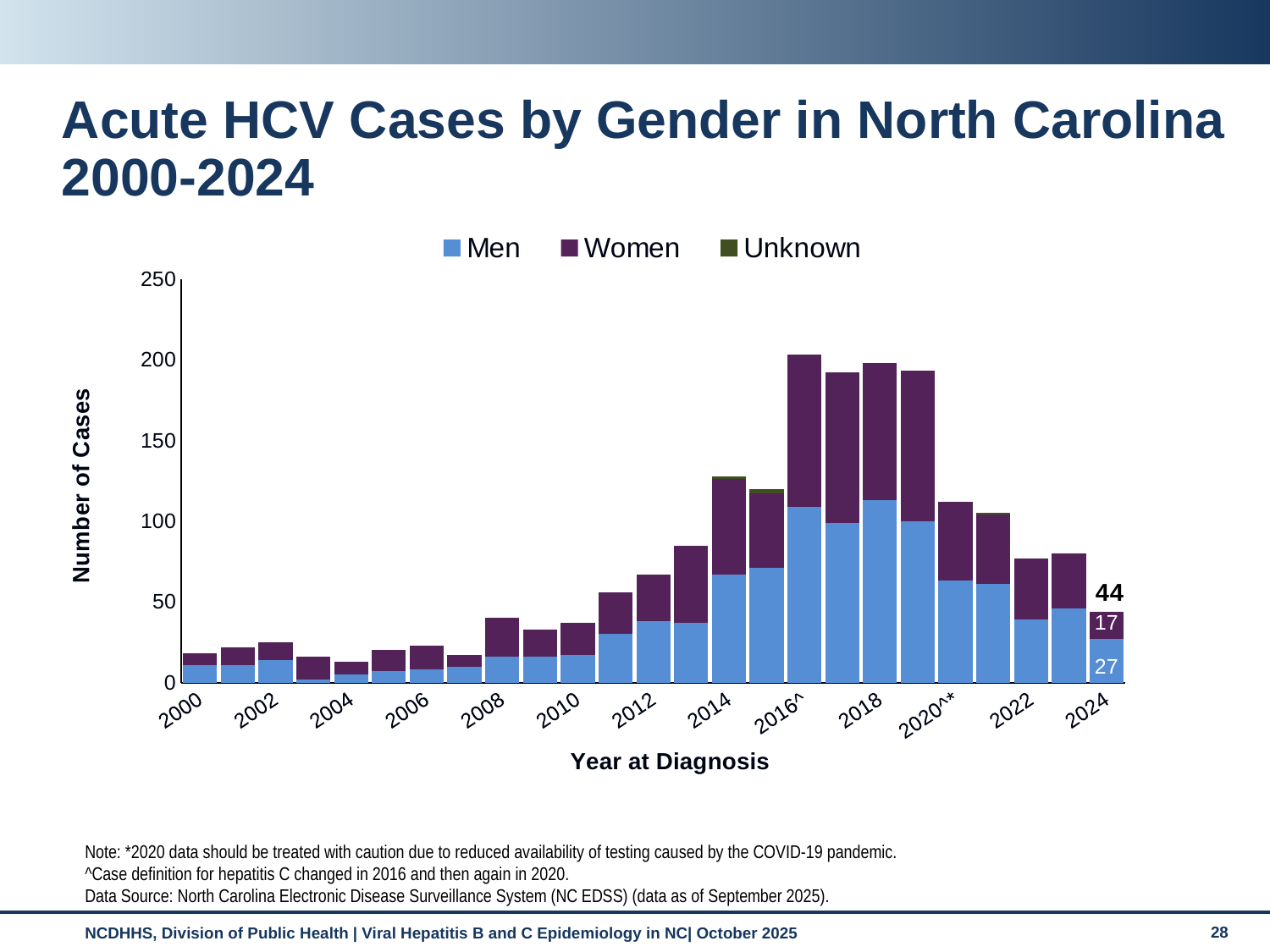
How many years are plotted on the x axis? 25 What kind of chart is shown on the slide? Stacked bar chart Do the total cases rise or fall from 2018 to 2024? fall How many cases among men were reported in 2024? 27 In 2024, how many more cases were among men than among women? 10 Is the total number of cases in 2014 greater or less than 100? greater What is the total number of acute HCV cases shown for 2024? 44 How many series does the legend list? 3 How many cases among women were reported in 2024? 17 What is the title of the x axis? Year at Diagnosis Is the total number of cases in 2022 greater or less than 100? less In 2024, were there more cases among men or among women? Men